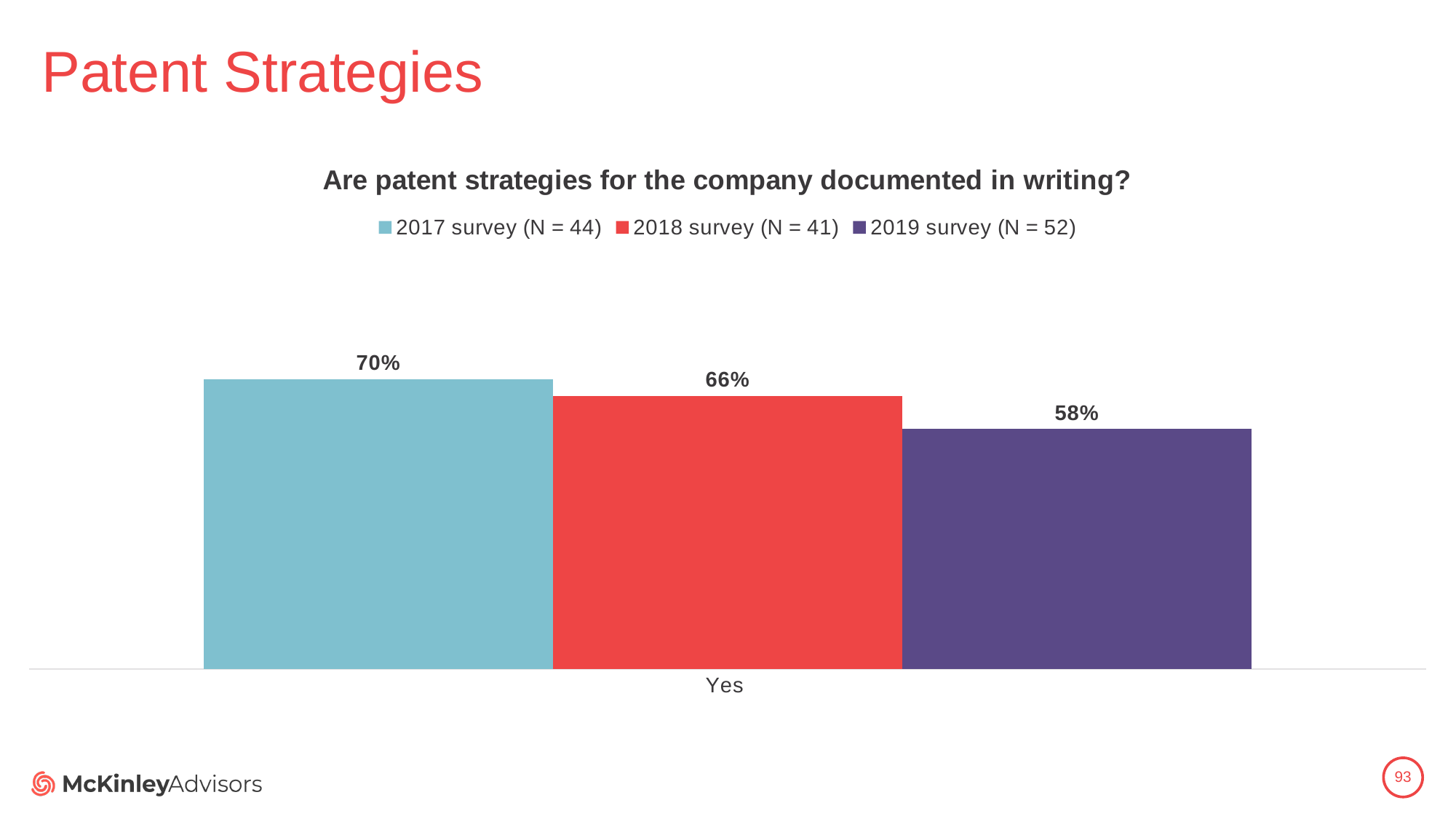
Which survey year has the lowest share of Yes responses? 2019 survey (N = 52) What percentage of respondents in the 2017 survey answered Yes? 70% What is the title of the chart? Are patent strategies for the company documented in writing? What kind of chart is shown on the slide? Bar chart How many series does the legend list? 3 What is the difference in percentage points between the 2018 survey and the 2019 survey Yes responses? 8 What percentage of respondents in the 2019 survey answered Yes? 58% Which survey year has the highest share of Yes responses? 2017 survey (N = 44) Which is larger, the Yes share in the 2017 survey or in the 2018 survey? 2017 survey What is the difference in percentage points between the 2017 survey and the 2019 survey Yes responses? 12 What percentage of respondents in the 2018 survey answered Yes? 66% Do the Yes percentages rise or fall from the 2017 survey to the 2019 survey? Fall